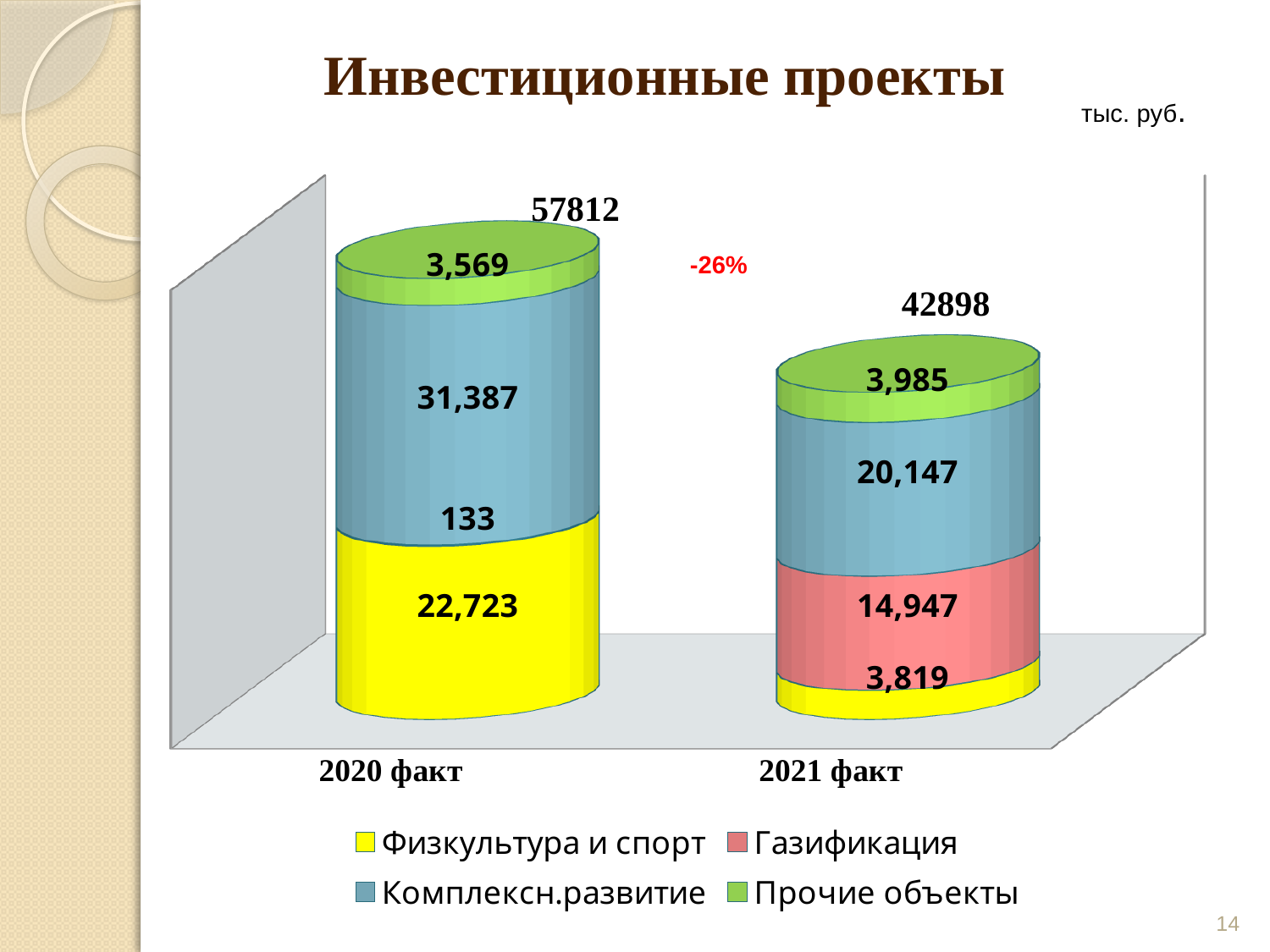
How many series does the legend list? 4 What is the total of the stacked bar for 2021 факт? 42898 What is the value for Газификация in 2021 факт? 14,947 Which is larger: Прочие объекты in 2020 факт or in 2021 факт? 2021 факт What percentage change is annotated between the two bars? -26% What is the value for Комплексн.развитие in 2021 факт? 20,147 Which series has the largest value in 2020 факт? Комплексн.развитие What is the value for Физкультура и спорт in 2020 факт? 22,723 What is the value for Прочие объекты in 2020 факт? 3,569 What is the difference between the Физкультура и спорт values for 2020 факт and 2021 факт? 18,904 Which series has the smallest value in 2021 факт? Физкультура и спорт What is the total of the stacked bar for 2020 факт? 57812